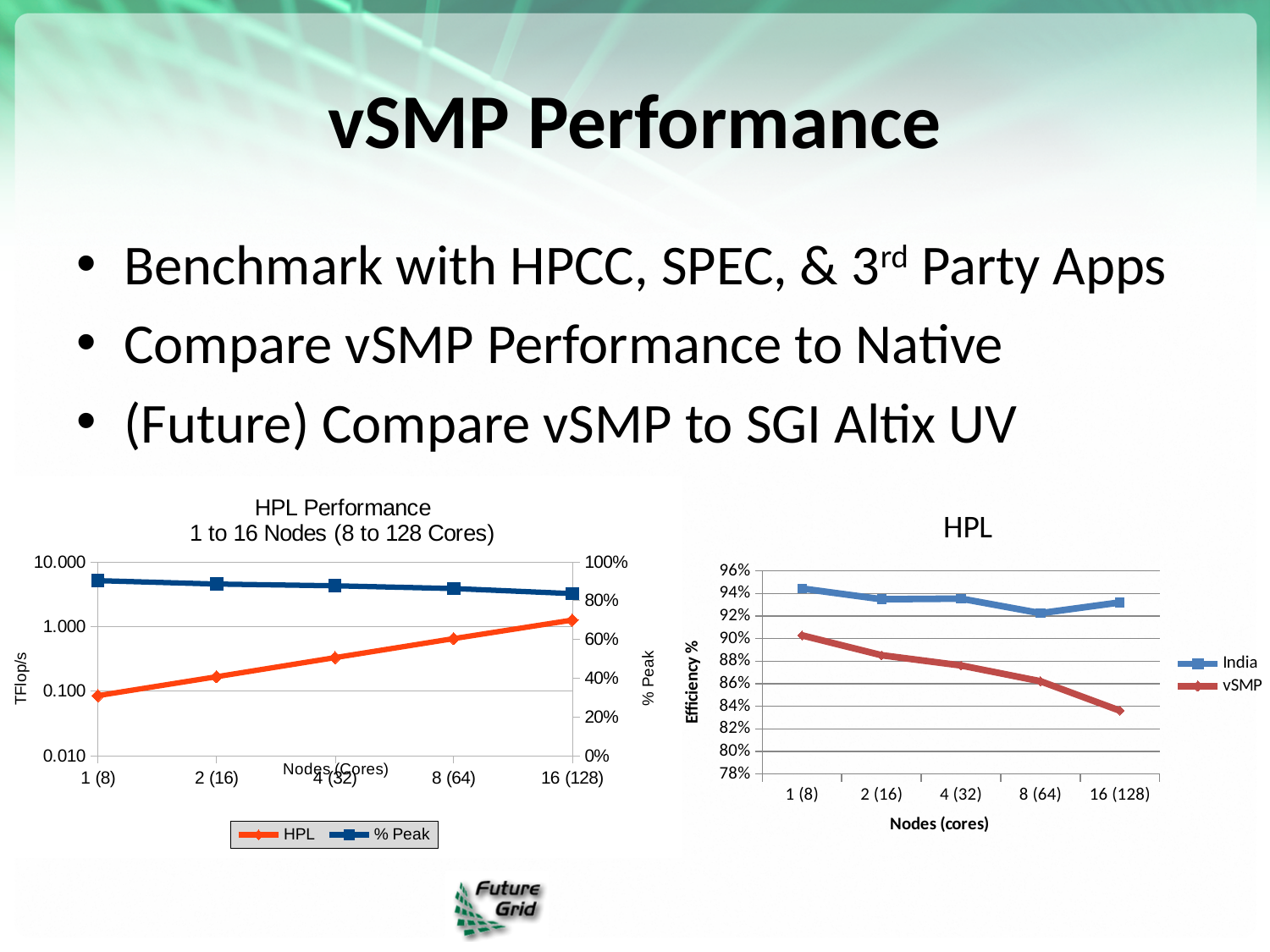
How many series does the legend of the left 'HPL Performance' chart list? 2 In the left 'HPL Performance' chart, is the % Peak value at 1 (8) greater or less than 80%? greater How many node (core) categories are shown on the x axis of the right 'HPL' chart? 5 In the right 'HPL' chart, at which node count is vSMP efficiency lowest? 16 (128) In the right 'HPL' chart, which series has the higher efficiency at 16 (128), India or vSMP? India In the right 'HPL' chart, is the vSMP efficiency at 16 (128) greater or less than 86%? less In the left 'HPL Performance' chart, is the HPL value at 16 (128) greater or less than 1.000 TFlop/s? greater What type of chart is the 'HPL Performance 1 to 16 Nodes (8 to 128 Cores)' chart on the left? line chart In the right 'HPL' chart, does the vSMP efficiency rise or fall as the number of nodes increases? fall What is the label of the y axis on the right 'HPL' chart? Efficiency % In the left 'HPL Performance' chart, does the HPL series rise or fall as the number of nodes increases? rise In the right 'HPL' chart, at which node count is vSMP efficiency highest? 1 (8)